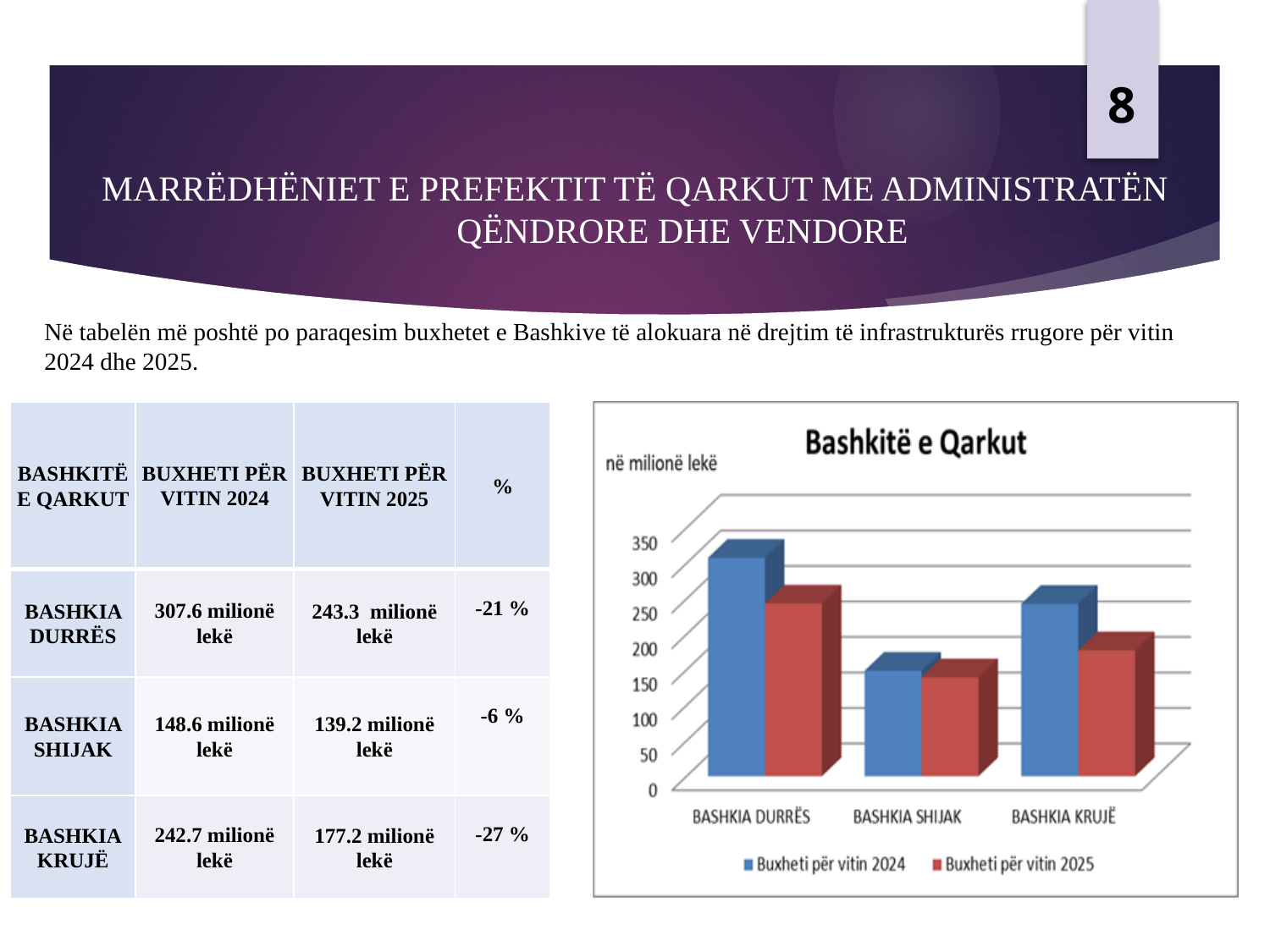
Is the value for Bashkia Shijak in Buxheti për vitin 2025 greater or less than 100? greater Which municipality has the lowest value for Buxheti për vitin 2025? Bashkia Shijak What kind of chart is shown on the slide? Bar chart What is the difference between the 2024 and 2025 budgets for Bashkia Durrës, using the values printed on the slide? 64.3 milionë lekë Is the value for Bashkia Krujë in Buxheti për vitin 2024 greater or less than 200? greater How many series does the legend of the chart list? 2 What is the budget for Bashkia Durrës for 2024, as printed on the slide? 307.6 milionë lekë What is the title of the chart? Bashkitë e Qarkut For Bashkia Durrës, which is larger: Buxheti për vitin 2024 or Buxheti për vitin 2025? Buxheti për vitin 2024 How many municipalities (categories) are shown on the x axis of the chart? 3 Which municipality has the lowest value for Buxheti për vitin 2024? Bashkia Shijak Which municipality has the highest value for Buxheti për vitin 2024? Bashkia Durrës